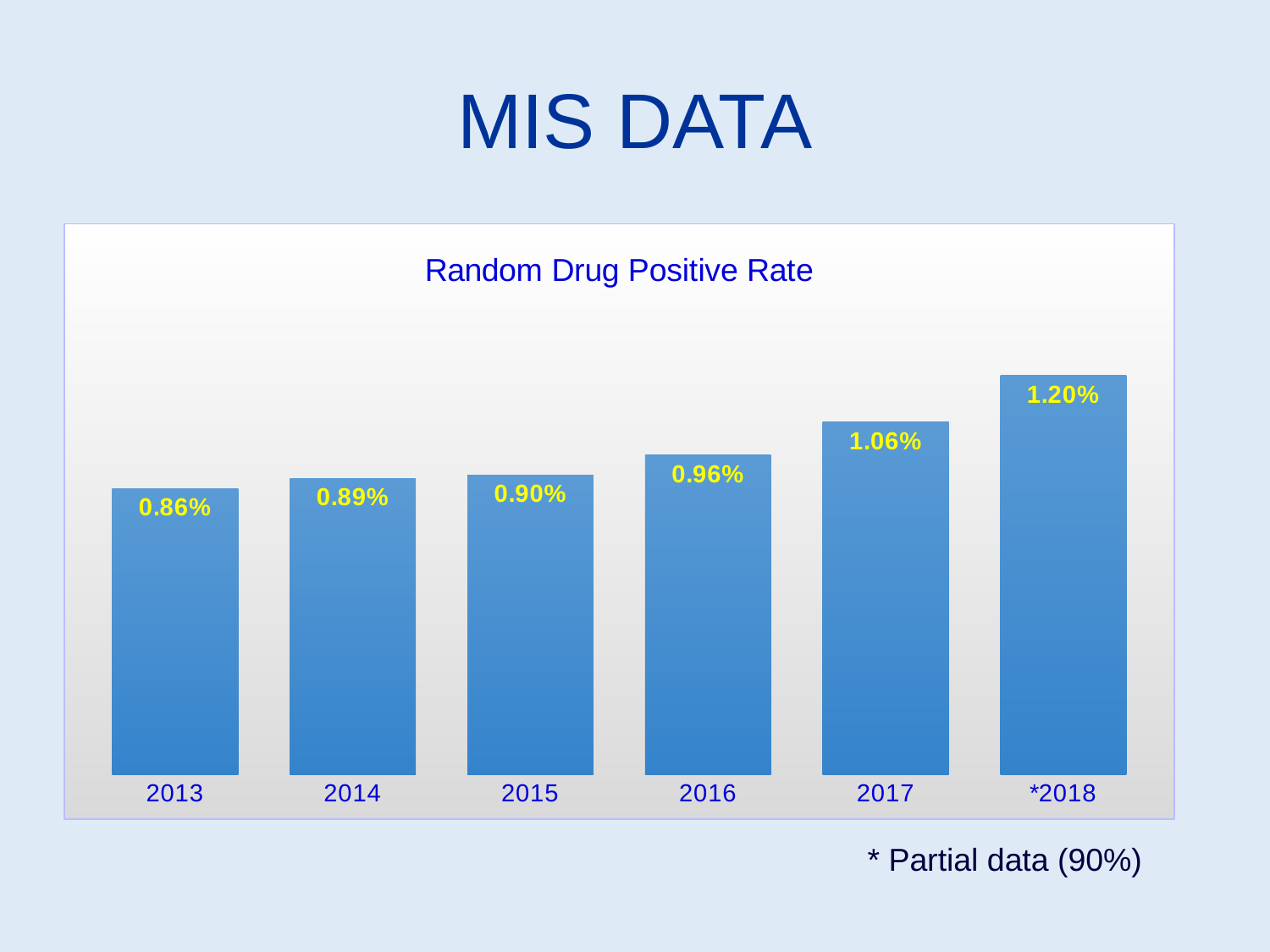
What is the random drug positive rate for 2016? 0.96% How many years are shown on the chart? 6 What is the title of the chart? Random Drug Positive Rate What kind of chart is shown on the slide? Bar chart What is the random drug positive rate for *2018? 1.20% Which year has the lowest random drug positive rate? 2013 What is the difference between the random drug positive rate in *2018 and in 2016? 0.24% What is the difference between the random drug positive rate in 2017 and in 2013? 0.20% Does the random drug positive rate rise or fall from 2013 to *2018? Rise Which year has the highest random drug positive rate? *2018 What is the random drug positive rate for 2013? 0.86% Which is larger, the random drug positive rate in 2017 or in 2015? 2017